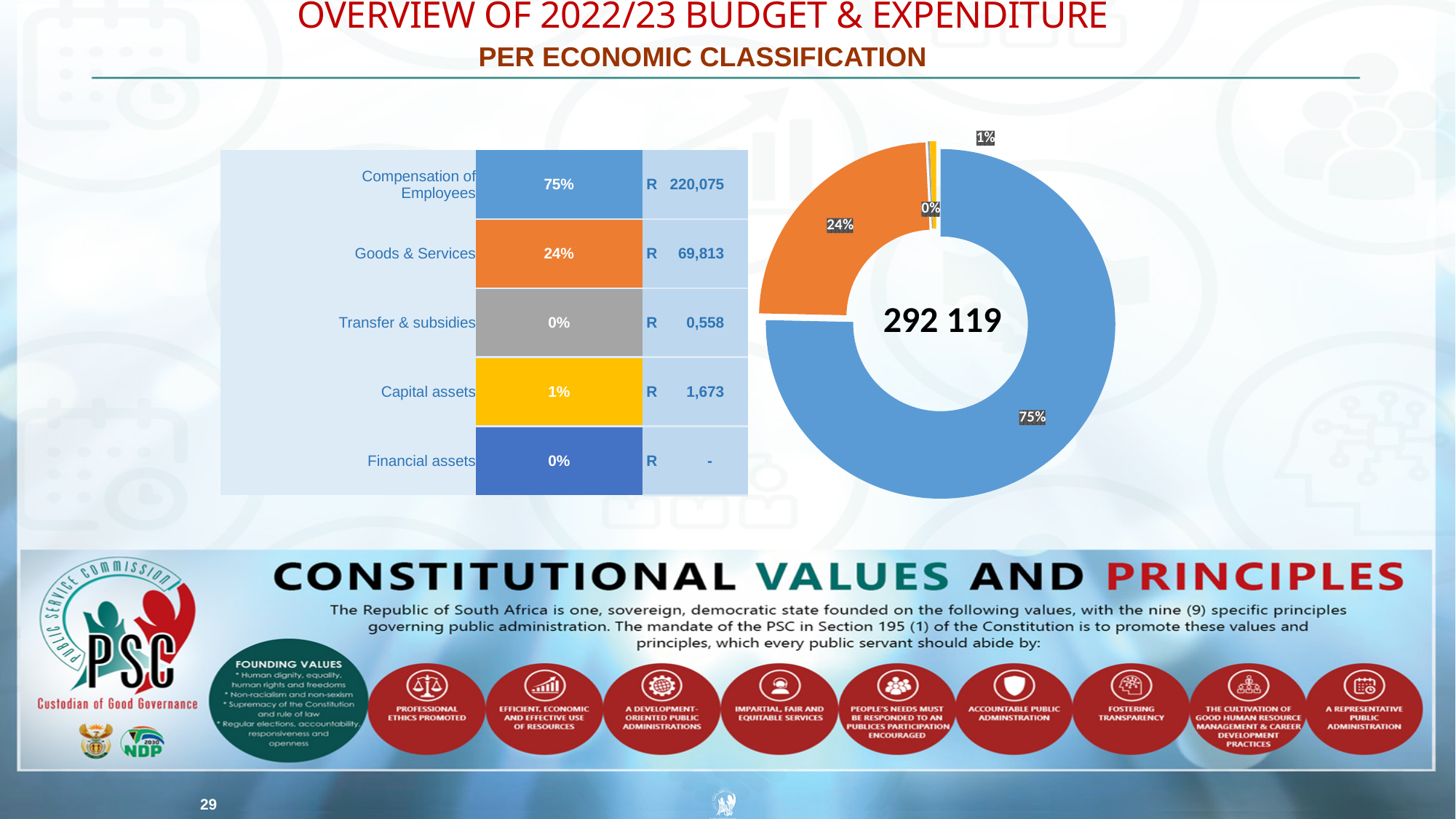
Which is larger in the doughnut chart, the Goods & Services slice or the Capital assets slice? Goods & Services Which economic classification has the largest slice in the doughnut chart? Compensation of Employees What share of the doughnut chart does Compensation of Employees represent? 75% What share of the doughnut chart does Capital assets represent? 1% What colour is the largest slice of the doughnut chart? Blue What kind of chart is shown on the slide? Doughnut chart What total value is printed in the centre of the doughnut chart? 292 119 What is the difference in percentage points between the Compensation of Employees slice and the Goods & Services slice? 51% What is the amount shown for Compensation of Employees in the table next to the chart? R 220,075 What share of the doughnut chart does Transfer & subsidies represent? 0% What is the amount shown for Goods & Services in the table next to the chart? R 69,813